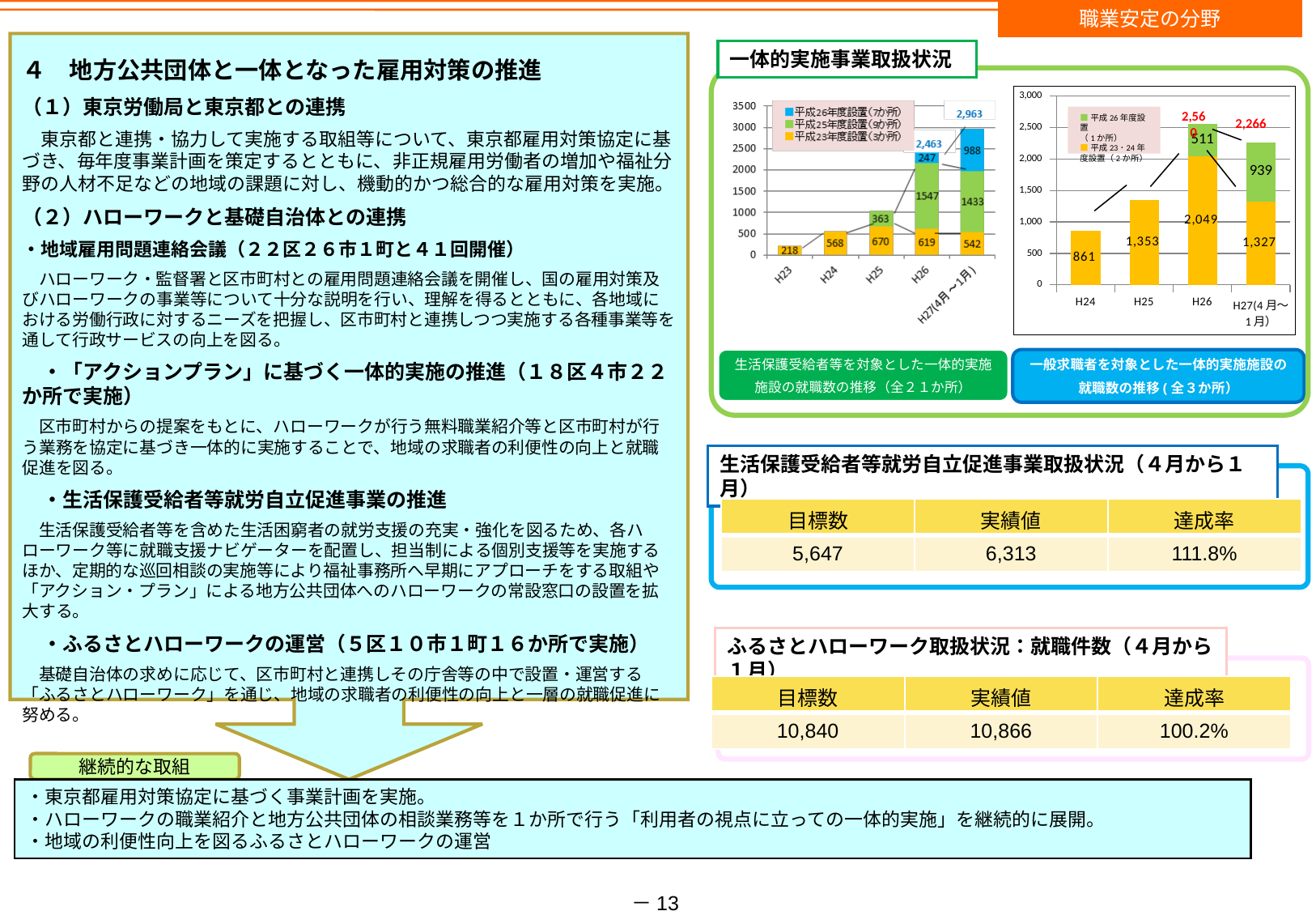
In the left chart (生活保護受給者等を対象とした一体的実施施設の就職数の推移), what is the total labelled above the H27(4月～1月) bar? 2,963 In the left chart (生活保護受給者等を対象とした一体的実施施設の就職数の推移), how many series does the legend list? 3 In the right chart (一般求職者を対象とした一体的実施施設の就職数の推移), what is the 平成26年度設置 segment value for H27(4月～1月)? 939 In the left chart (生活保護受給者等を対象とした一体的実施施設の就職数の推移), what is the value for H23? 218 In the right chart (一般求職者を対象とした一体的実施施設の就職数の推移), what is the value for H25? 1,353 In the right chart (一般求職者を対象とした一体的実施施設の就職数の推移), which category has the highest total? H26 In the left chart (生活保護受給者等を対象とした一体的実施施設の就職数の推移), what is the difference between the H27(4月～1月) total and the H26 total? 500 In the right chart (一般求職者を対象とした一体的実施施設の就職数の推移), how many categories are shown on the x axis? 4 In the left chart (生活保護受給者等を対象とした一体的実施施設の就職数の推移), which category has the lowest total? H23 In the left chart (生活保護受給者等を対象とした一体的実施施設の就職数の推移), what is the total of the H25 stacked bar? 1033 What kind of chart is the right chart (一般求職者を対象とした一体的実施施設の就職数の推移)? Stacked bar chart In the left chart (生活保護受給者等を対象とした一体的実施施設の就職数の推移), what is the 平成25年度設置 segment value for H26? 1547